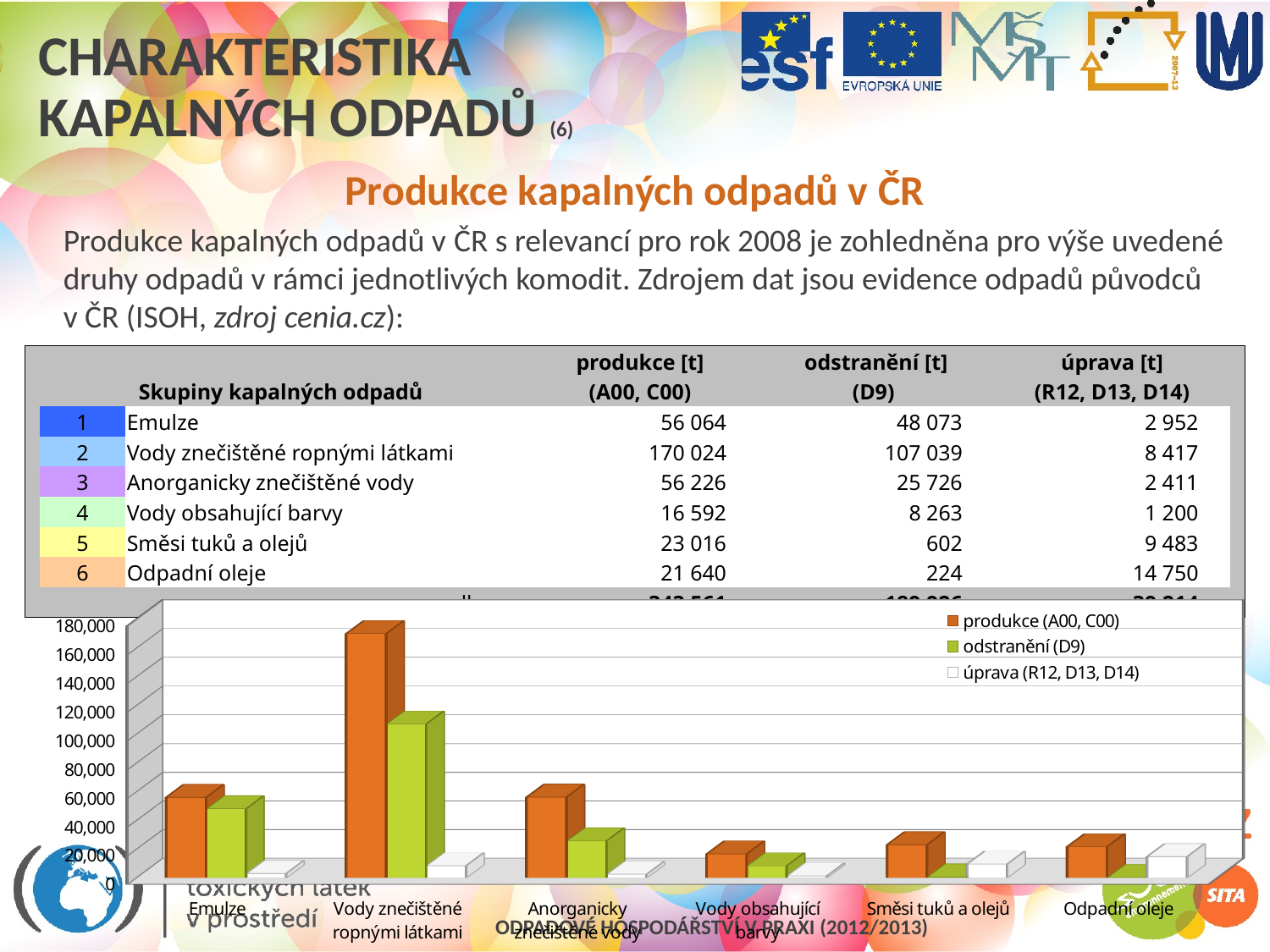
Which waste group has the lowest produkce (A00, C00) value? Vody obsahující barvy Which colour represents the produkce (A00, C00) series in the chart legend? orange Which is larger: the odstranění (D9) value for Emulze or for Anorganicky znečištěné vody? Emulze Is the odstranění (D9) value for Emulze greater or less than 60,000? less What is the odstranění (D9) value for Vody znečištěné ropnými látkami, as printed in the table? 107 039 Which waste group has the highest úprava (R12, D13, D14) value? Odpadní oleje Which waste group has the highest produkce (A00, C00) value? Vody znečištěné ropnými látkami What is the produkce (A00, C00) value for Emulze, as printed in the table? 56 064 What kind of chart is shown at the bottom of the slide? bar chart How many series does the chart legend list? 3 Is the produkce (A00, C00) value for Vody znečištěné ropnými látkami greater or less than 160,000? greater How many waste groups (categories) are plotted along the x axis of the chart? 6